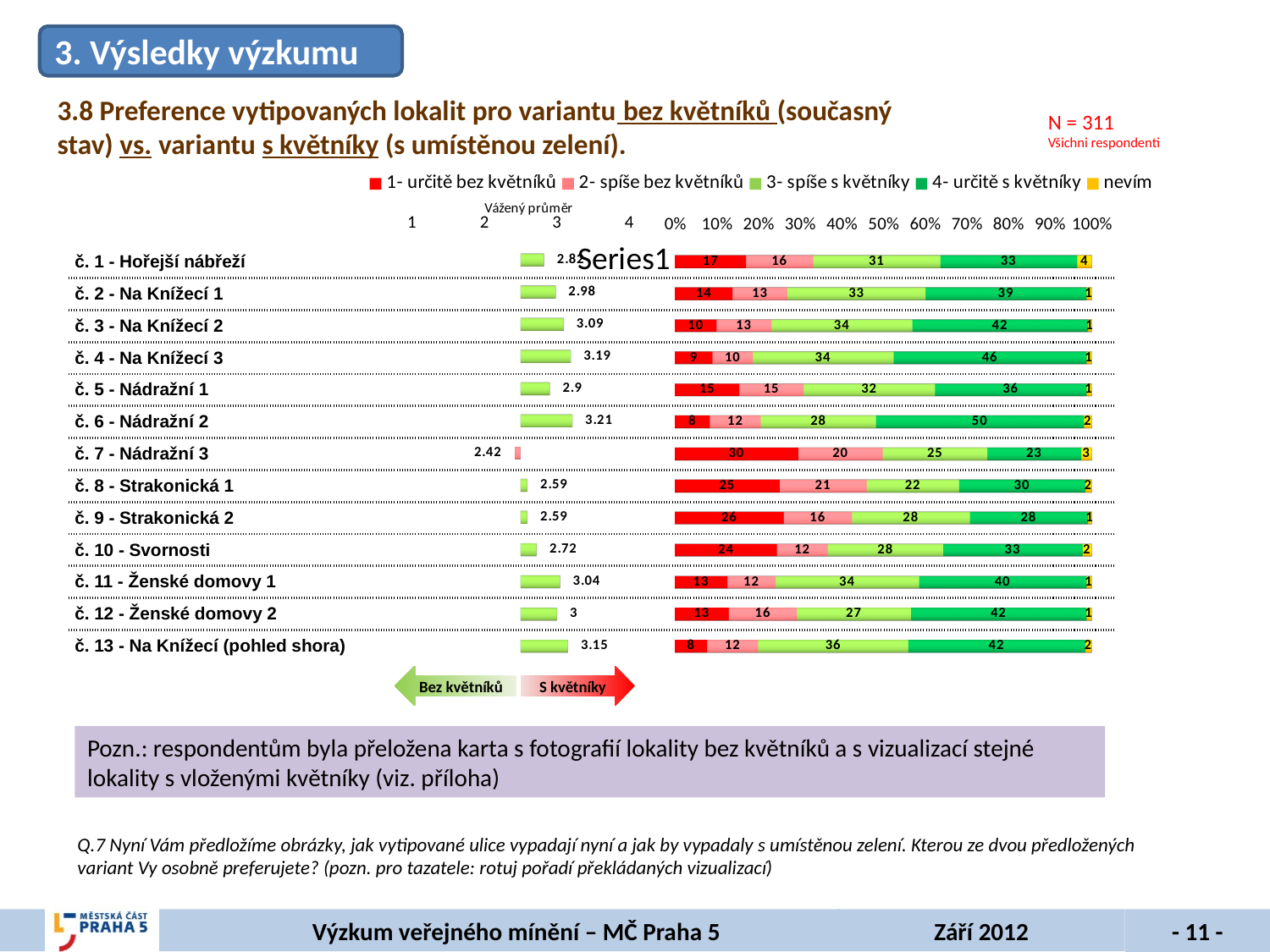
In the weighted average chart (Vážený průměr), what is the value for č. 6 - Nádražní 2? 3.21 In the weighted average chart (Vážený průměr), what is the value for č. 12 - Ženské domovy 2? 3 In the stacked percentage chart, which is larger: the '1- určitě bez květníků' value for č. 8 - Strakonická 1 or for č. 4 - Na Knížecí 3? č. 8 - Strakonická 1 In the stacked percentage chart, what is the difference between the '3- spíše s květníky' values for č. 13 - Na Knížecí (pohled shora) and č. 7 - Nádražní 3? 11 How many localities are shown in the stacked percentage chart? 13 In the weighted average chart (Vážený průměr), which locality has the highest weighted average? č. 6 - Nádražní 2 What type of chart is the stacked percentage chart on the right? Stacked bar chart How many series does the legend of the stacked percentage chart list? 5 In the stacked percentage chart, which locality has the highest value for '4- určitě s květníky'? č. 6 - Nádražní 2 In the stacked percentage chart, what is the value of '1- určitě bez květníků' for č. 7 - Nádražní 3? 30 In the weighted average chart (Vážený průměr), which locality has the lowest weighted average? č. 7 - Nádražní 3 In the stacked percentage chart, what is the value of '4- určitě s květníky' for č. 6 - Nádražní 2? 50